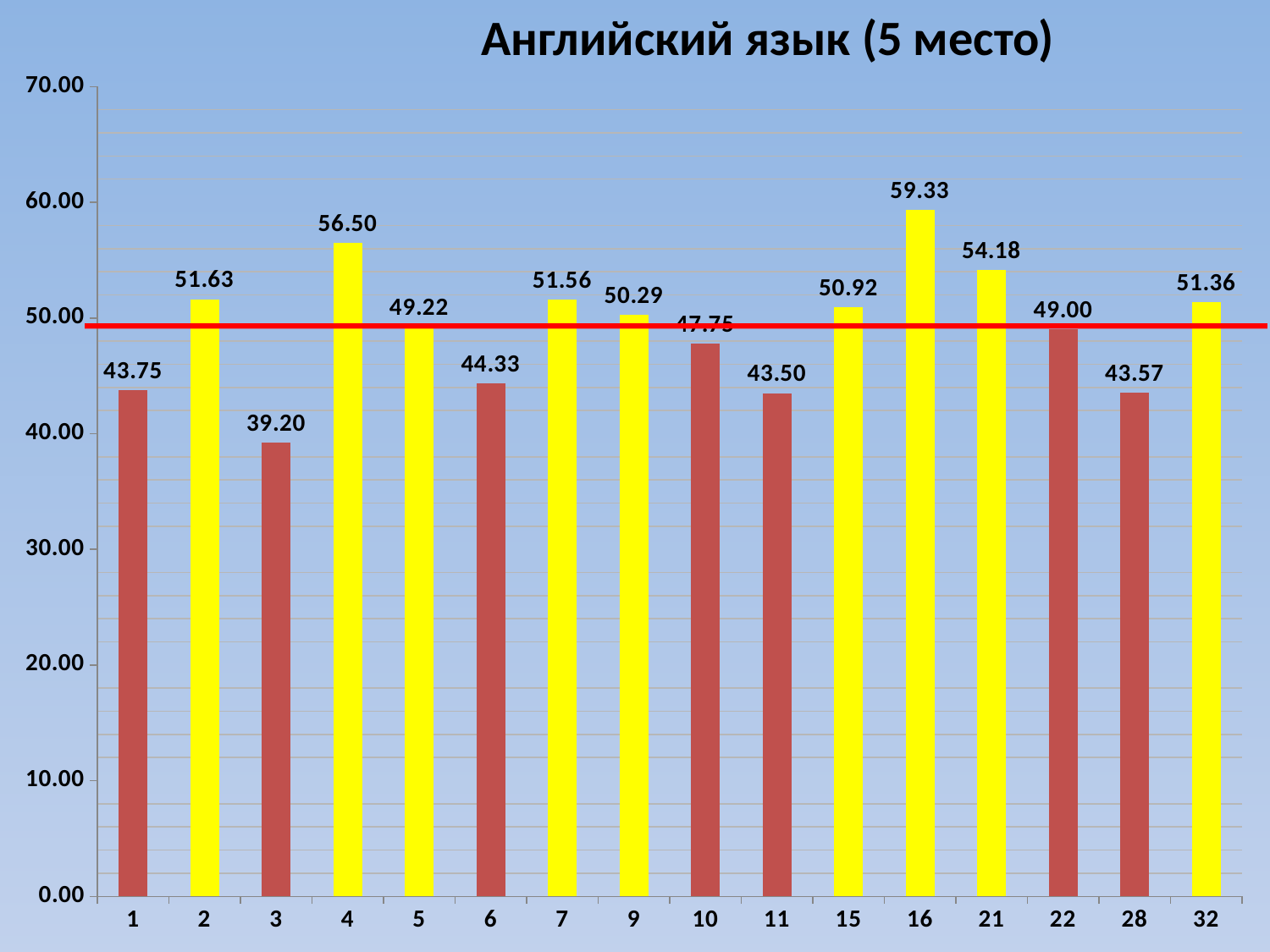
Which category has the lowest value? 3 What is the value for category 3? 39.20 How many categories are shown on the x axis? 16 What is the title of the chart? Английский язык (5 место) What is the difference between the values for category 4 and category 1? 12.75 Which category has the highest value? 16 What is the difference between the values for category 16 and category 3? 20.13 What is the value for category 16? 59.33 Is the value for category 10 greater or less than 50? less Which has the larger value, category 4 or category 21? 4 What kind of chart is shown on the slide? bar chart What is the value for category 22? 49.00